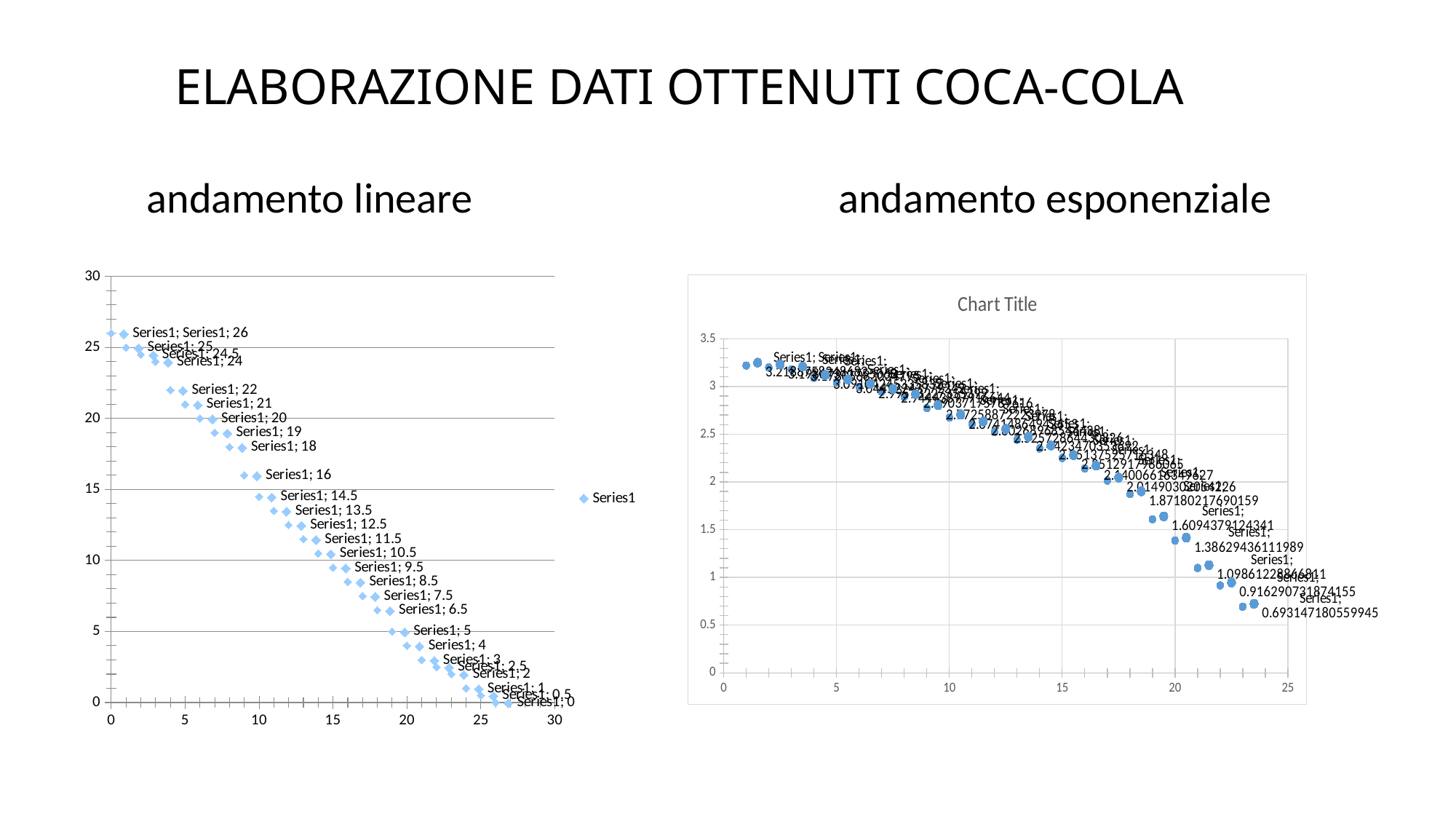
How many series does the legend of the left chart (andamento lineare) list? 1 In the right chart (andamento esponenziale), is the value of the last point (0.693147180559945) greater or less than 1? less What is the title shown inside the right chart's plot area? Chart Title What kind of chart is the left chart titled "andamento lineare"? scatter chart In the right chart (andamento esponenziale), what is the lowest labelled value? 0.693147180559945 In the left chart (andamento lineare), is the value of the first point at x = 0 greater or less than 20? greater In the left chart (andamento lineare), what is the highest labelled value? 26 What kind of chart is the right chart titled "andamento esponenziale"? scatter chart In the left chart (andamento lineare), what is the lowest labelled value? 0 In the left chart (andamento lineare), do the values rise or fall as the x axis increases? fall In the right chart (andamento esponenziale), do the values rise or fall as the x axis increases? fall In the left chart (andamento lineare), what is the difference between the highest labelled value (26) and the lowest labelled value (0)? 26